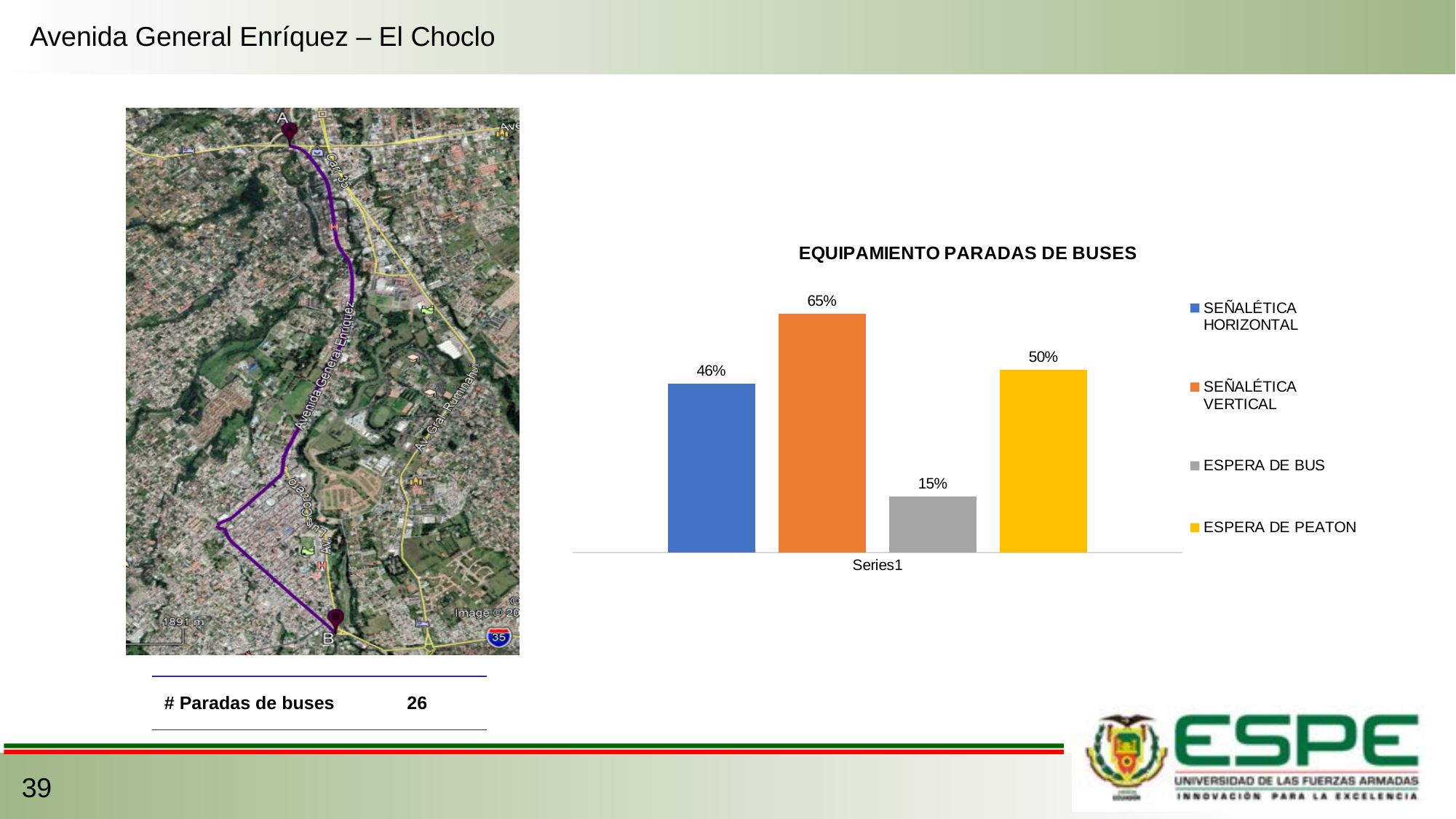
What kind of chart is shown on the slide? Bar chart How many entries does the chart legend list? 4 How many bars are plotted in the chart? 4 What is the title of the chart? EQUIPAMIENTO PARADAS DE BUSES What is the value for ESPERA DE PEATON in the chart? 50% What is the value for SEÑALÉTICA HORIZONTAL in the EQUIPAMIENTO PARADAS DE BUSES chart? 46% What is the difference between the values for SEÑALÉTICA VERTICAL and ESPERA DE BUS? 50% Which category has the lowest value in the chart? ESPERA DE BUS Which category has the highest value in the chart? SEÑALÉTICA VERTICAL What is the value for ESPERA DE BUS in the chart? 15% Which is larger, the value for ESPERA DE PEATON or SEÑALÉTICA HORIZONTAL? ESPERA DE PEATON What is the value for SEÑALÉTICA VERTICAL in the chart? 65%